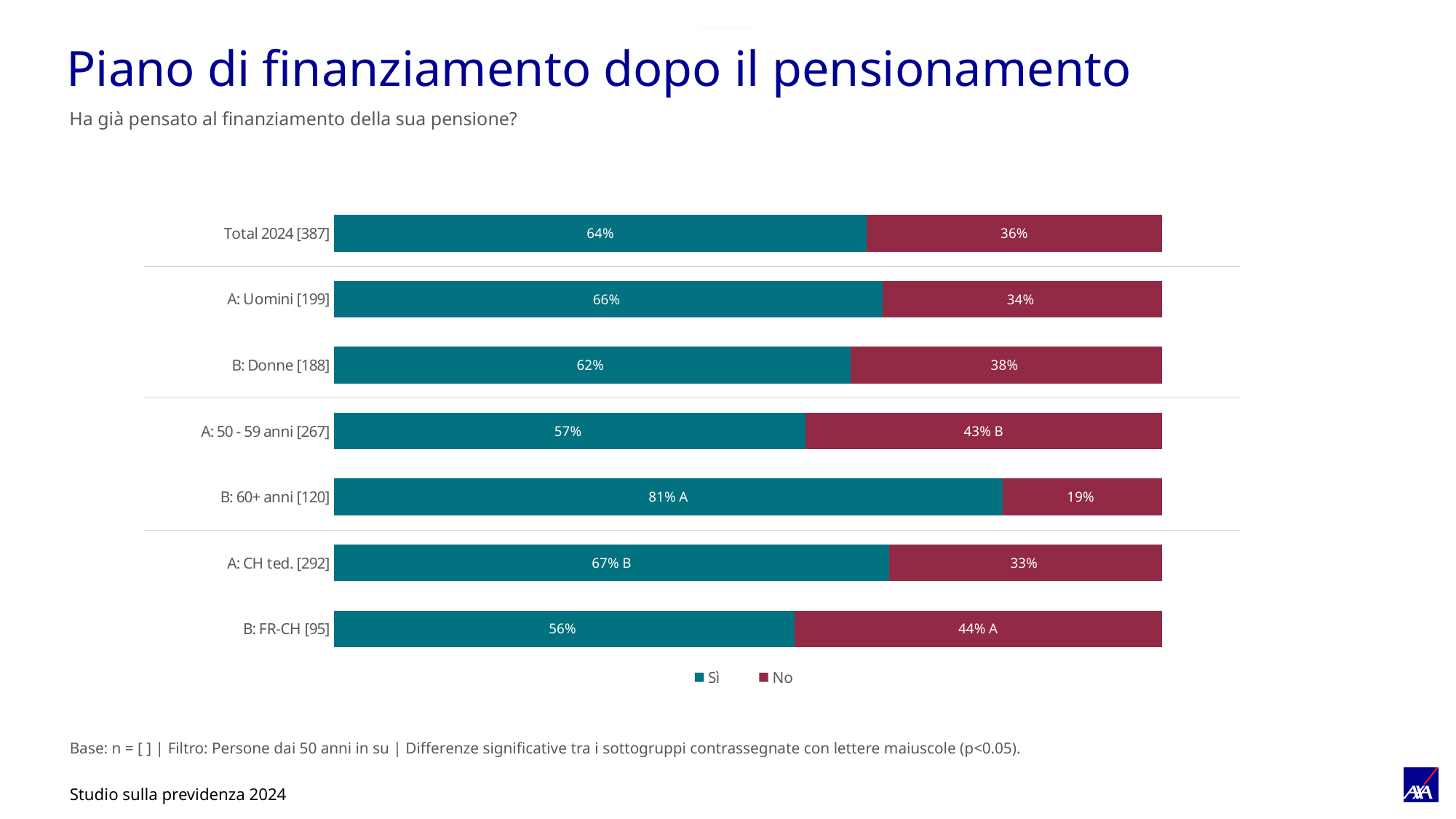
What is the total of the stacked bar for A: 50 - 59 anni [267]? 100% Which has a larger 'Sì' value, A: CH ted. [292] or B: FR-CH [95]? A: CH ted. [292] Which category has the lowest 'No' value? B: 60+ anni [120] How many series does the legend list? 2 What is the 'No' value for B: FR-CH [95]? 44% What is the 'Sì' value for Total 2024 [387]? 64% What kind of chart is shown on the slide? Stacked bar chart What is the difference between the 'Sì' values for A: Uomini [199] and B: Donne [188]? 4% What is the 'No' value for B: Donne [188]? 38% How many categories are shown in the chart? 7 What is the 'Sì' value for B: 60+ anni [120]? 81% Which category has the highest 'Sì' value? B: 60+ anni [120]